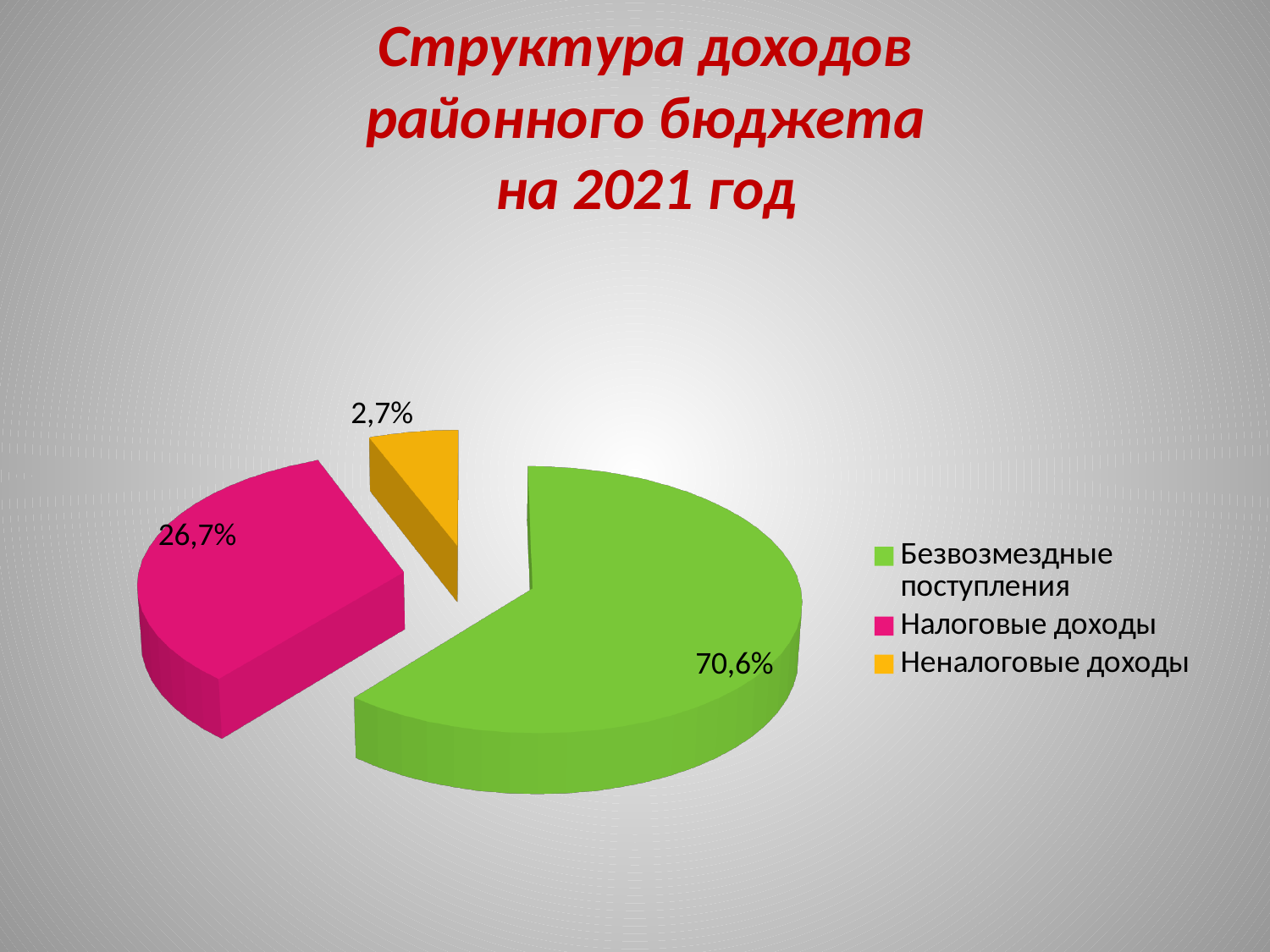
Which category has the smallest share of the pie? Неналоговые доходы What share of the pie does Неналоговые доходы have? 2,7% What is the title of the chart on the slide? Структура доходов районного бюджета на 2021 год How many categories are shown in the pie chart? 3 What colour is the slice for Налоговые доходы? Pink What share of the pie does Безвозмездные поступления have? 70,6% What is the difference in percentage points between Налоговые доходы and Неналоговые доходы? 24 Which is larger: the share for Налоговые доходы or the share for Неналоговые доходы? Налоговые доходы Which category has the largest share of the pie? Безвозмездные поступления What is the difference in percentage points between Безвозмездные поступления and Налоговые доходы? 43,9 What kind of chart is shown on the slide? Pie chart What share of the pie does Налоговые доходы have? 26,7%